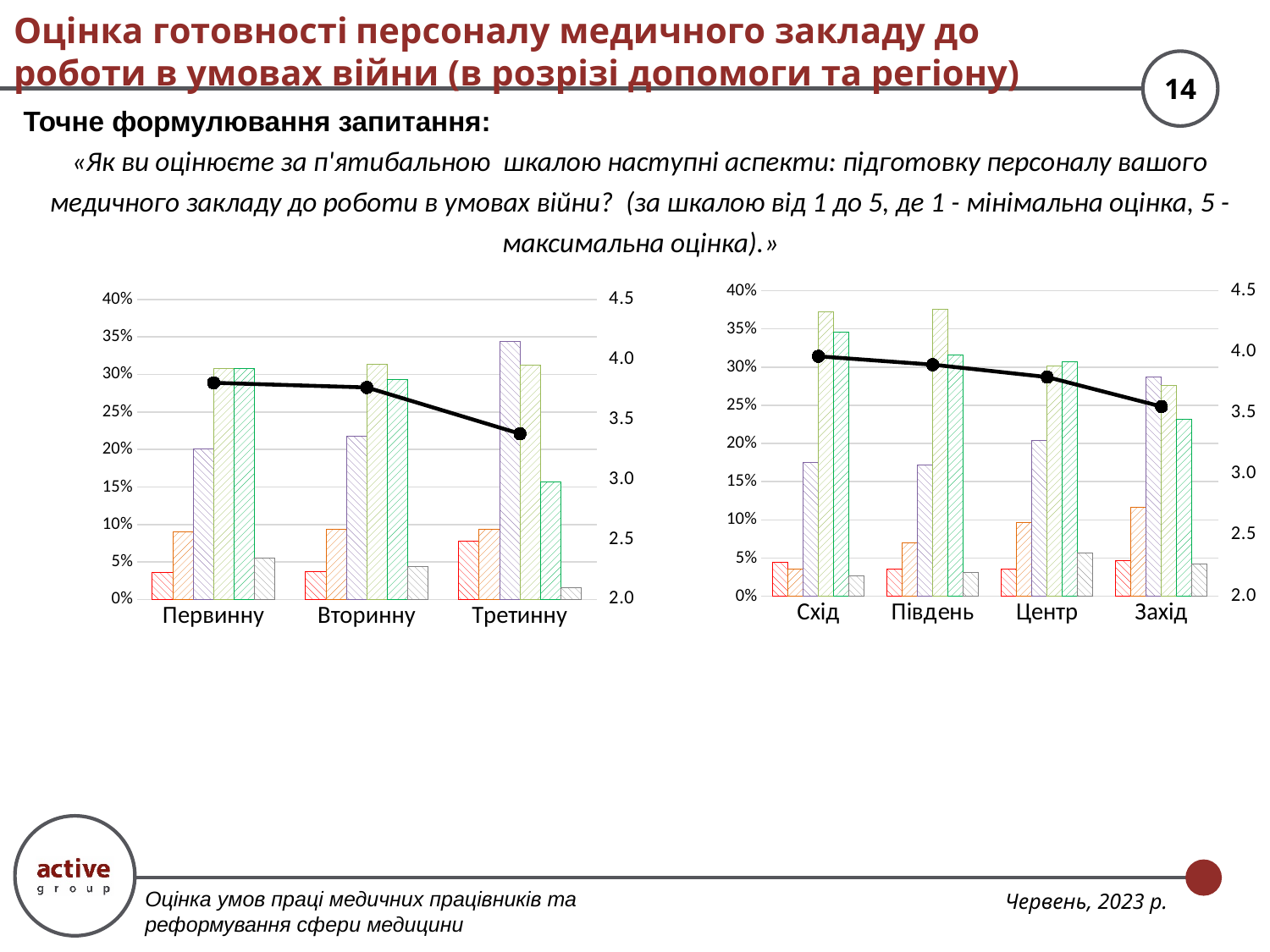
On the left chart, how many categories are shown on the x axis? 3 On the left chart, is the line value for Третинну greater or less than 3.5? less On the right chart, does the line rise or fall from Схід to Захід? Fall On the right chart, which has the larger line value, Схід or Захід? Схід On the left chart, which category has the lowest line value? Третинну On the right chart, is the line value for Схід greater or less than 3.5? greater On the right chart, which category has the lowest line value? Захід On the left chart, is the line value for Первинну greater or less than 3.5? greater On the left chart, what is the maximum value shown on the left (percentage) axis? 40% On the right chart, how many categories are shown on the x axis? 4 On the left chart, does the line rise or fall from Первинну to Третинну? Fall What kind of chart is the left chart? Combined bar and line chart